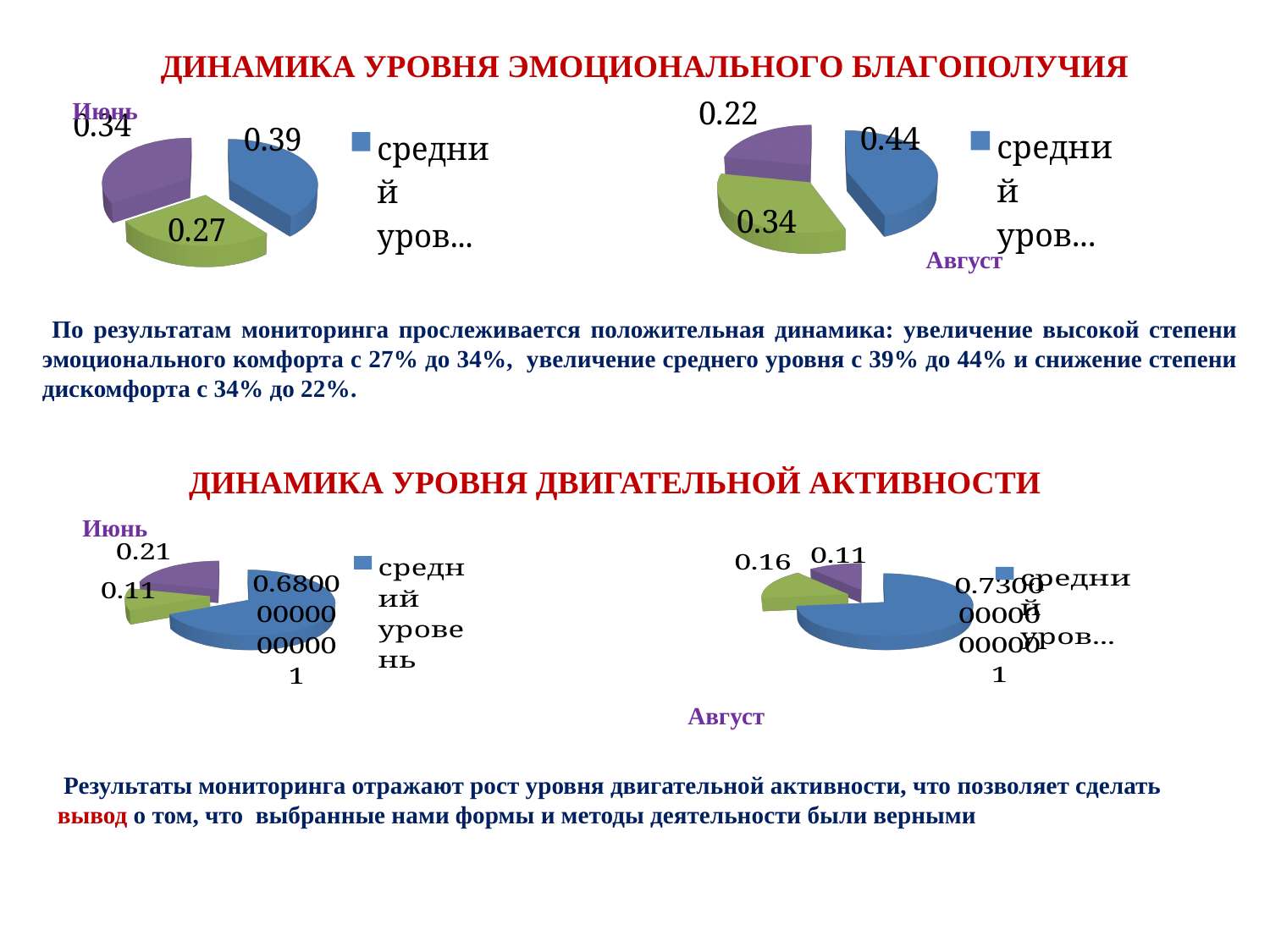
What kind of chart is the top-left chart labelled Июнь under ДИНАМИКА УРОВНЯ ЭМОЦИОНАЛЬНОГО БЛАГОПОЛУЧИЯ? Pie chart In the bottom-right pie chart (Август, motor activity), which is larger: the green slice or the purple slice? Green (0.16) In the top-left pie chart (Июнь, emotional well-being), what is the value of the green slice? 0.27 How many slices does the top-right pie chart (Август, emotional well-being) have? 3 In the top-right pie chart (Август, emotional well-being), what is the difference between the blue slice (0.44) and the purple slice (0.22)? 0.22 In the bottom-right pie chart (Август, motor activity), which colour slice is the largest? Blue In the bottom-left pie chart (Июнь, motor activity), what is the value of the purple slice? 0.21 In the top-left pie chart (Июнь, emotional well-being), which slice has the smallest value? Green (0.27) In the bottom-left pie chart (Июнь, motor activity), what is the value of the green slice? 0.11 In the top-left pie chart (Июнь, emotional well-being), what is the value of the blue slice? 0.39 In the top-right pie chart (Август, emotional well-being), what is the value of the purple slice? 0.22 In the top-right pie chart (Август, emotional well-being), which slice has the largest value? Blue (0.44)